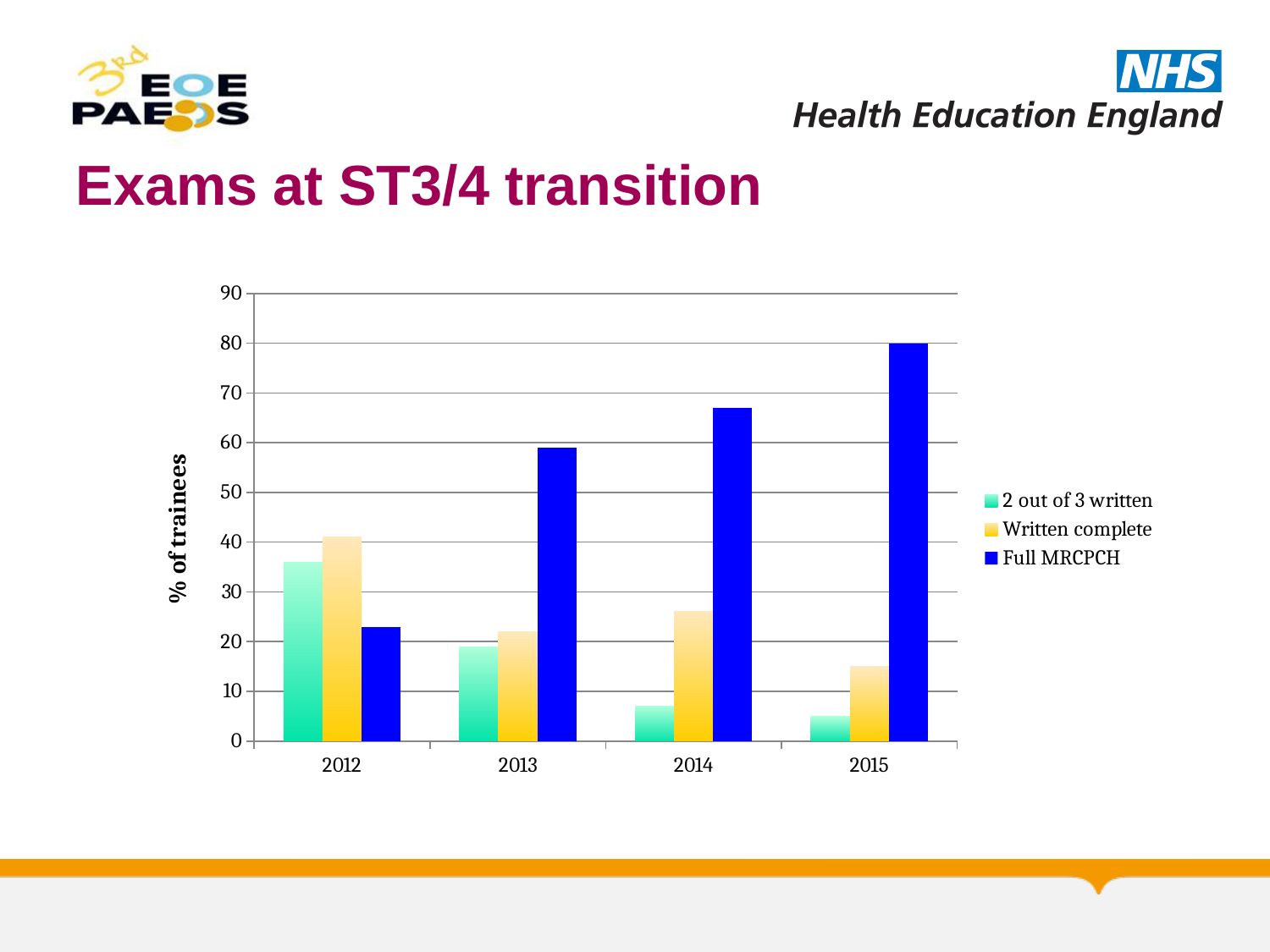
What is the label on the y axis of the chart? % of trainees How many years are shown on the x axis of the chart? 4 Is the Full MRCPCH value for 2012 greater or less than 30? less What kind of chart is shown on the slide? Bar chart How many series does the chart's legend list? 3 In which year is the Full MRCPCH value highest? 2015 Do the Full MRCPCH values rise or fall from 2012 to 2015? Rise In which year is the '2 out of 3 written' value lowest? 2015 Is the Full MRCPCH value for 2014 greater or less than 60? greater In 2013, which is larger: the 'Written complete' value or the Full MRCPCH value? Full MRCPCH Do the '2 out of 3 written' values rise or fall from 2012 to 2015? Fall